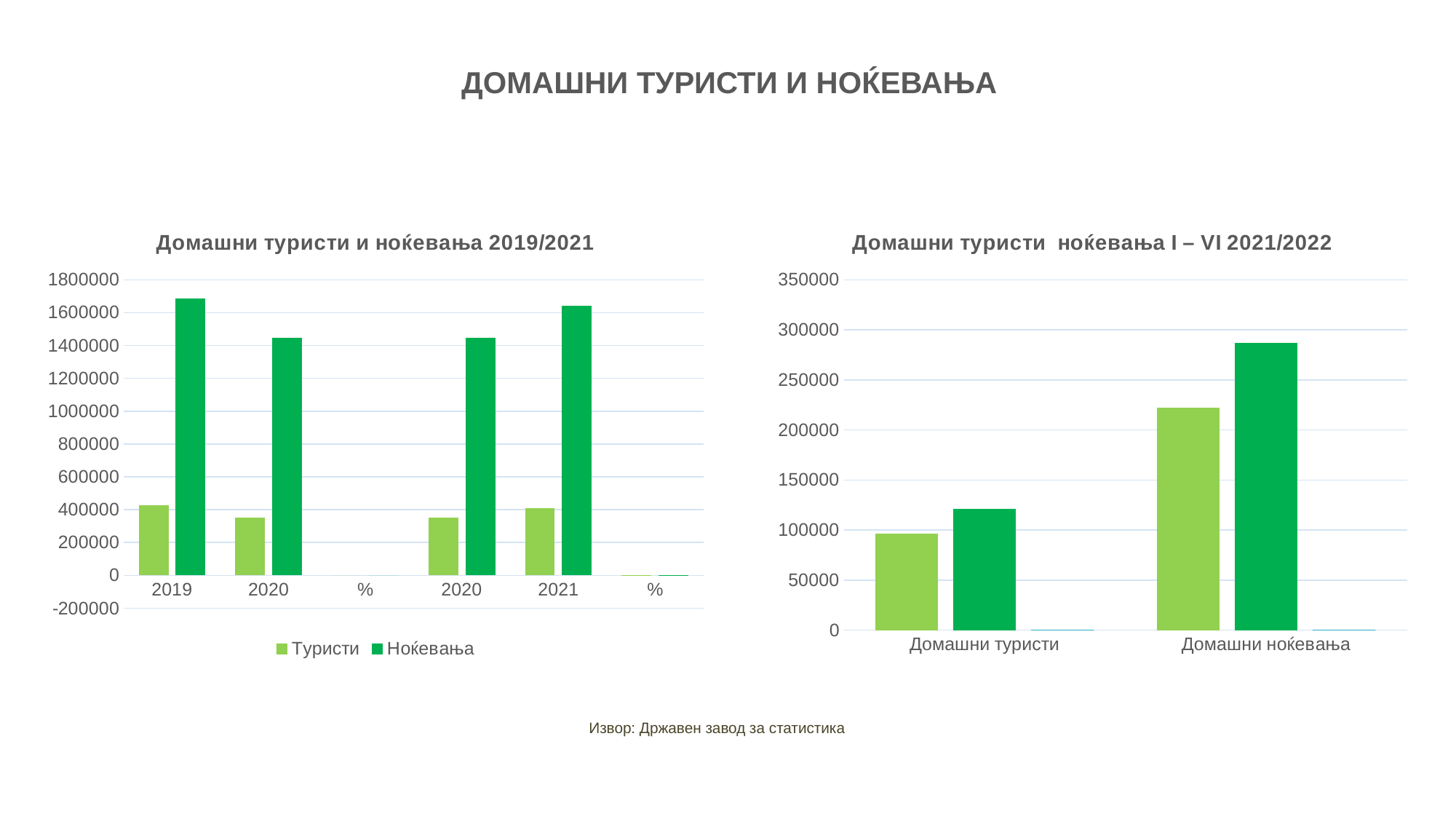
What is the title of the right chart? Домашни туристи ноќевања I – VI 2021/2022 How many category labels are shown on the x axis of the left chart? 6 How many categories are shown on the x axis of the right chart? 2 How many series does the legend of the left chart list? 2 In the left chart, is the value of Туристи for 2020 greater or less than 400000? less In the left chart, which is larger: Ноќевања for 2019 or Ноќевања for 2020? Ноќевања for 2019 What are the two series named in the legend of the left chart? Туристи and Ноќевања In the right chart, is the dark green bar for Домашни ноќевања greater or less than 250000? greater What kind of chart is the left chart titled "Домашни туристи и ноќевања 2019/2021"? bar chart In the left chart, is the value of Ноќевања for 2020 greater or less than 1600000? less